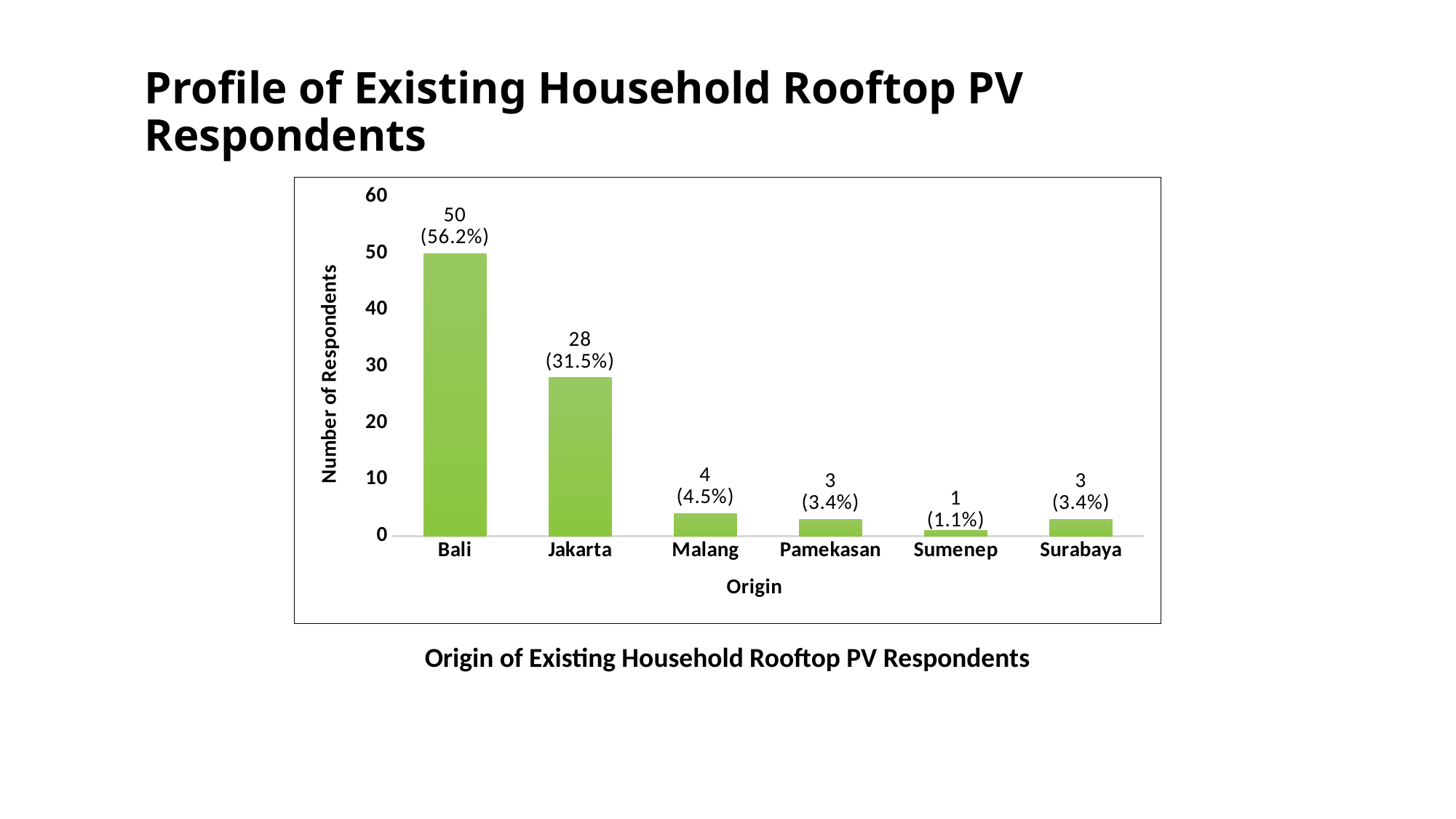
Which origin has the lowest number of respondents? Sumenep What percentage of respondents are from Jakarta? 31.5% How many origin categories are shown on the x axis? 6 Which origin has the highest number of respondents? Bali How many respondents are from Sumenep? 1 Is the number of respondents from Jakarta greater or less than 30? less What kind of chart is shown on the slide? bar chart How many respondents are from Bali? 50 What is the difference in the number of respondents between Bali and Jakarta? 22 Which has more respondents, Malang or Pamekasan? Malang What is the caption below the chart? Origin of Existing Household Rooftop PV Respondents What is the label of the y axis? Number of Respondents